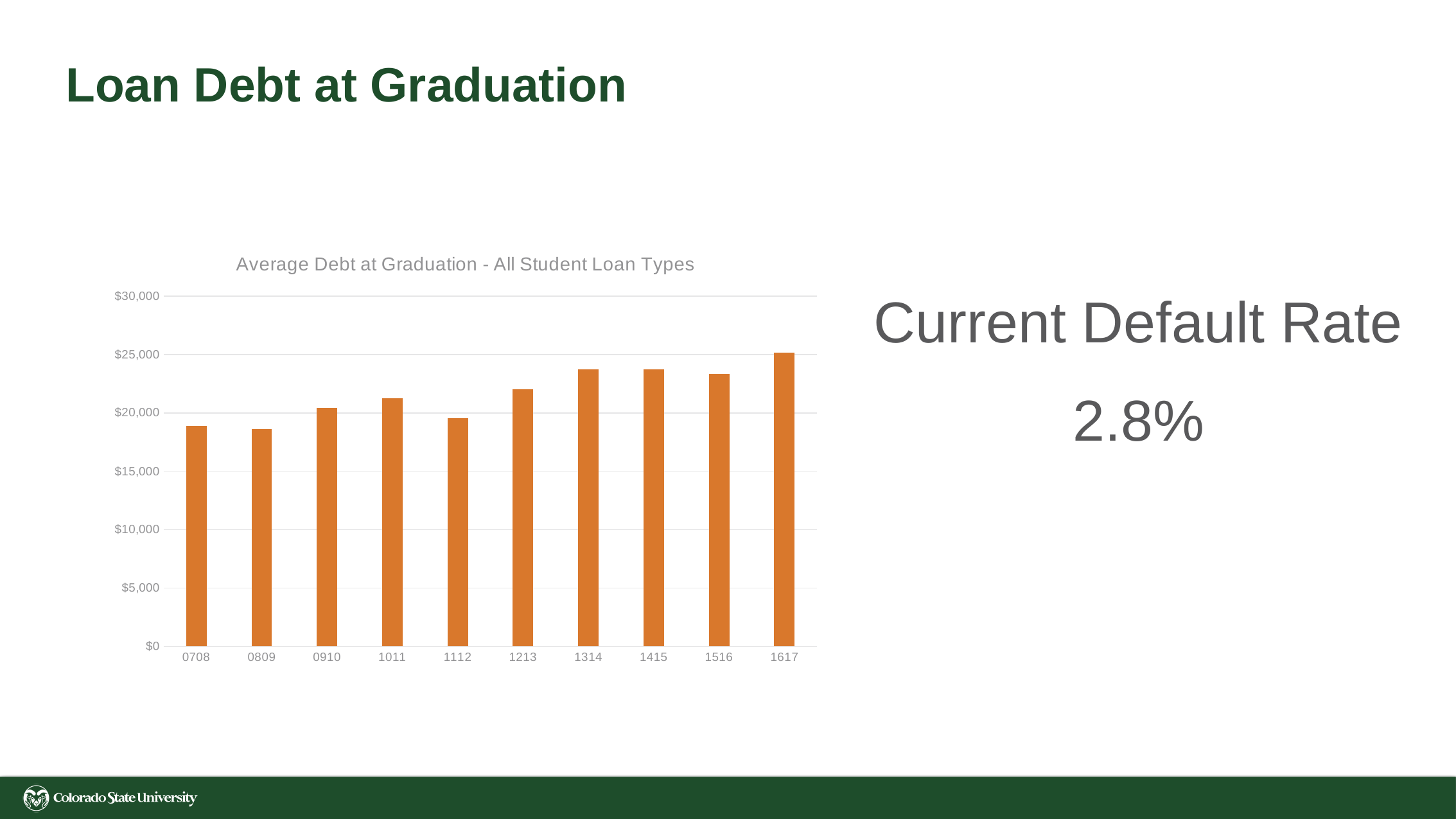
Is the average debt for 1314 greater or less than $20,000? greater Which year has the larger average debt, 1617 or 0708? 1617 Which year has the larger average debt, 1213 or 1112? 1213 What colour are the bars in the chart? Orange Overall, does average debt at graduation rise or fall from 0708 to 1617? Rise What kind of chart is shown on the slide? Bar chart How many academic years are shown on the x axis of the chart? 10 What is the title of the chart? Average Debt at Graduation - All Student Loan Types Which year has the highest average debt at graduation? 1617 Is the average debt for 0708 greater or less than $20,000? less Is the average debt for 1617 greater or less than $20,000? greater